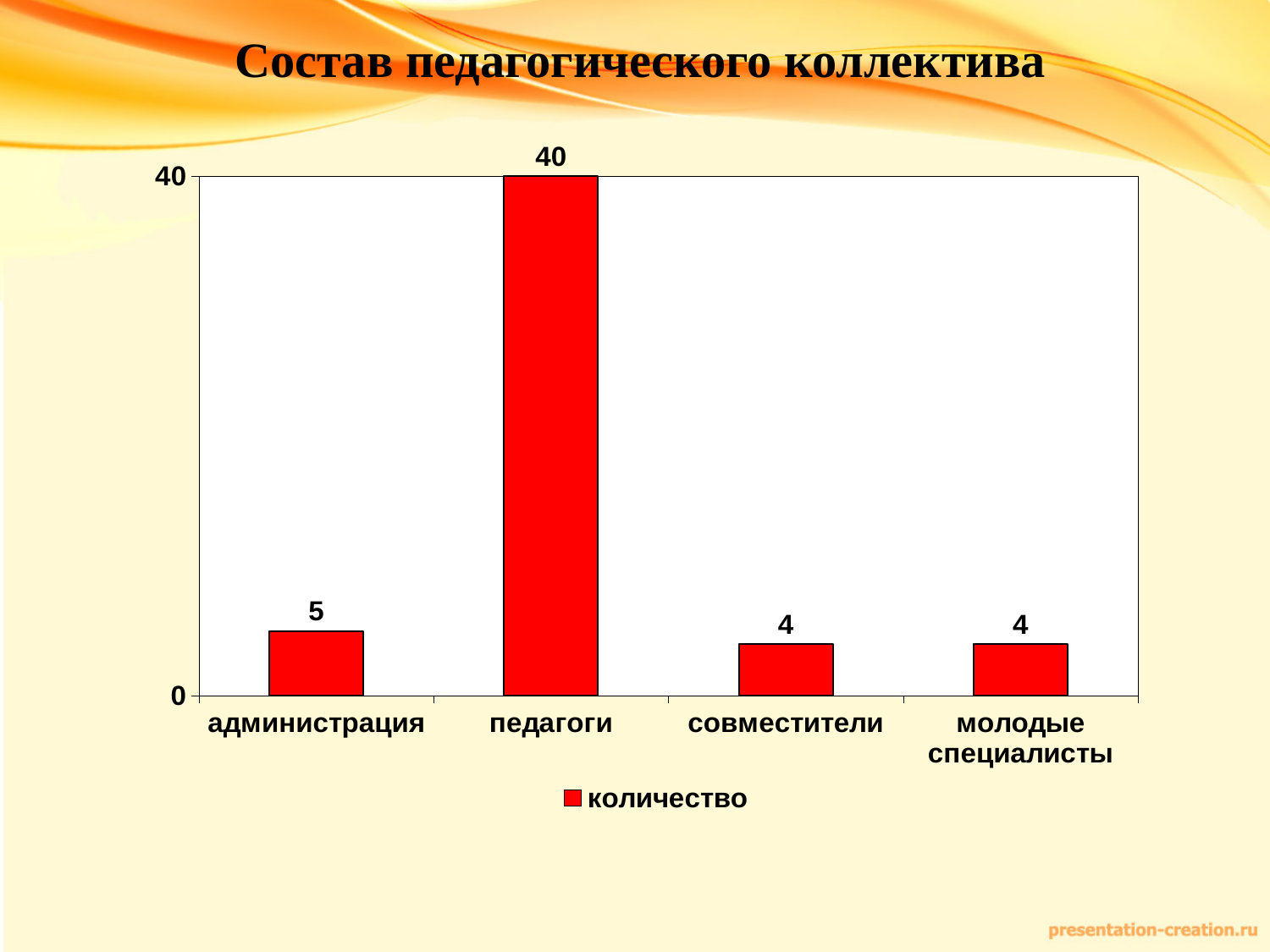
What is the value for педагоги? 40 What kind of chart is shown on the slide? bar chart What is the value for совместители? 4 What is the title of the chart? Состав педагогического коллектива How many series does the legend list? 1 Which is larger, the value for администрация or the value for совместители? администрация What is the name of the series in the legend? количество How many categories are shown on the x axis? 4 Which category has the highest value? педагоги What is the value for администрация? 5 What is the value for молодые специалисты? 4 What is the difference between the values for педагоги and администрация? 35